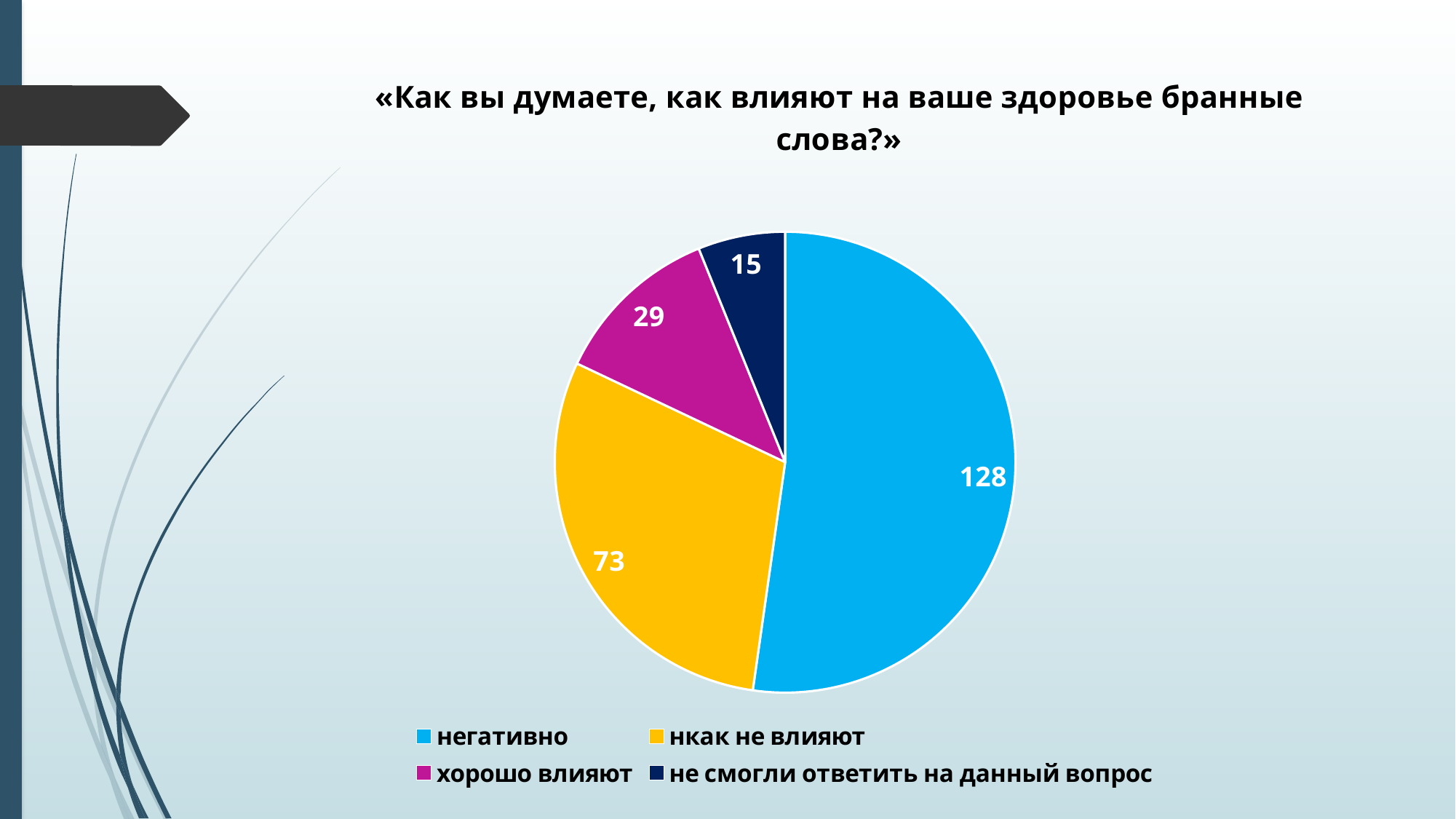
Which is larger, the value for «хорошо влияют» or for «не смогли ответить на данный вопрос»? хорошо влияют What is the difference between the values for «негативно» and «нкак не влияют»? 55 What is the value for «нкак не влияют»? 73 What is the title of the chart? «Как вы думаете, как влияют на ваше здоровье бранные слова?» What is the value for «не смогли ответить на данный вопрос»? 15 What is the total of all slices in the pie chart? 245 Which category has the smallest slice? не смогли ответить на данный вопрос Which category has the largest slice? негативно What kind of chart is shown on the slide? pie chart What is the value for «негативно»? 128 How many slices does the pie chart have? 4 What is the value for «хорошо влияют»? 29